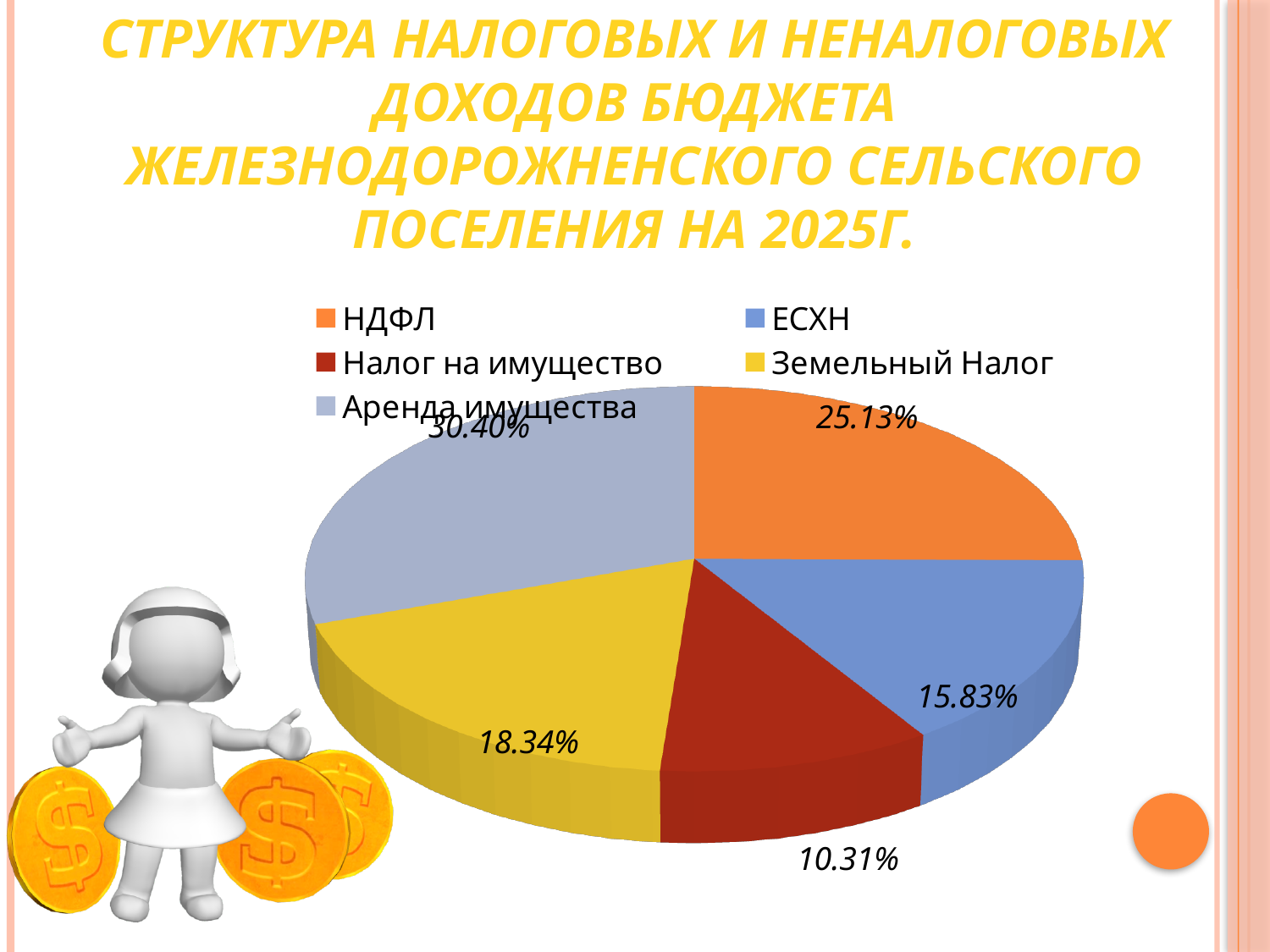
How many slices does the pie chart have? 5 What share of the pie does ЕСХН have? 15.83% Which category has the smallest share of the pie? Налог на имущество What share of the pie does Налог на имущество have? 10.31% What share of the pie does Земельный Налог have? 18.34% What kind of chart is shown on the slide? pie chart Which category has the largest share of the pie? Аренда имущества What share of the pie does Аренда имущества have? 30.40% Which is larger, the share for НДФЛ or the share for Земельный Налог? НДФЛ What colour is the slice for Земельный Налог? yellow What is the difference between the shares for Аренда имущества and ЕСХН? 14.57% What share of the pie does НДФЛ have? 25.13%